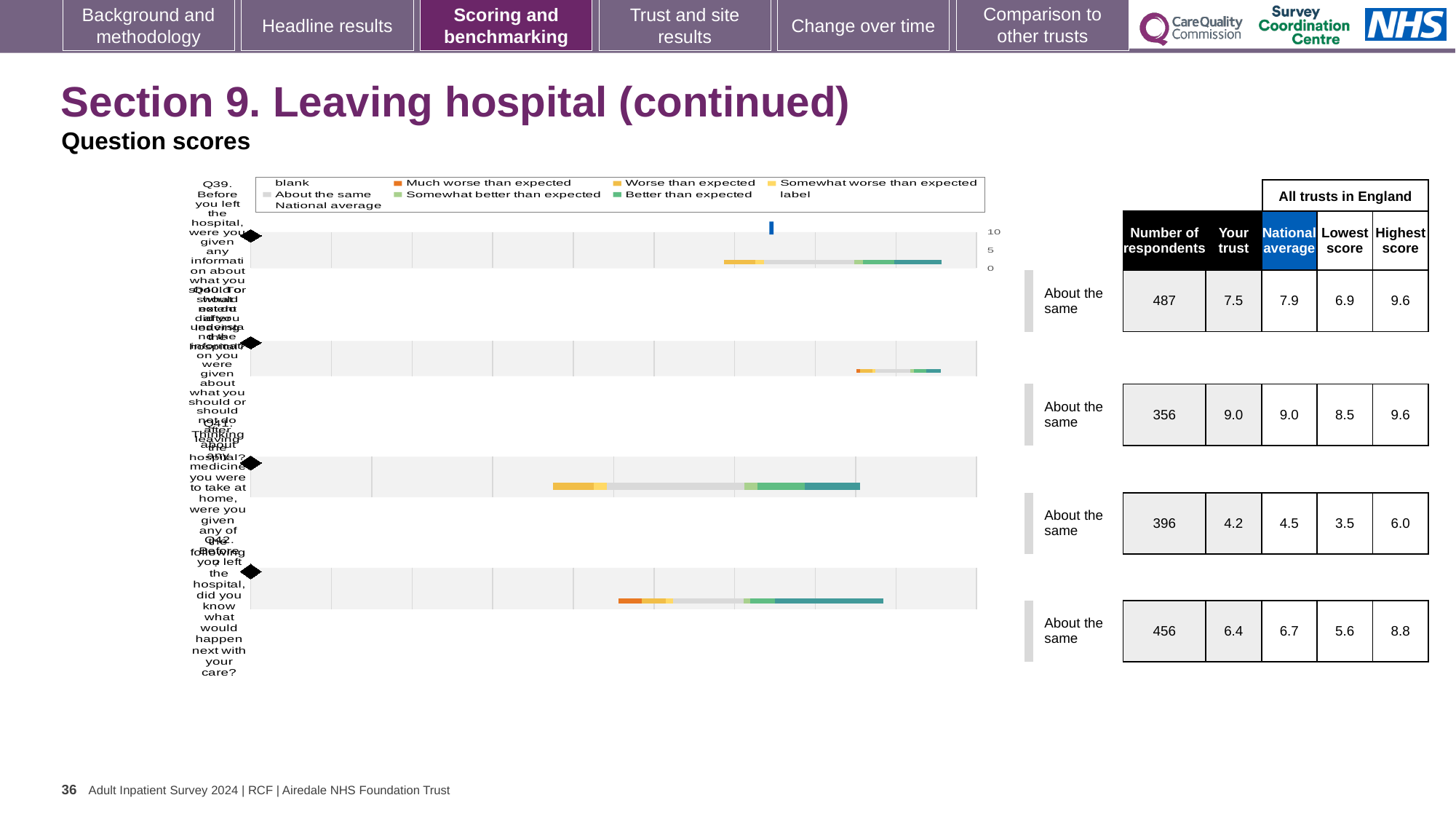
In the table next to the chart, what is the lowest score in the second row (Q40)? 8.5 In the table next to the chart, which row has the lowest 'Your trust' score? third row (4.2) Which legend entry is shown in orange in the chart? Much worse than expected How many question bars are plotted in the chart? 4 In the table next to the chart, which row has the highest number of respondents? first row (487) In the table next to the chart, what is the 'Your trust' score in the first row (Q39)? 7.5 In the table next to the chart, what is the difference between the national average and the 'Your trust' score in the first row? 0.4 In the table next to the chart, is the 'Your trust' score in the fourth row larger or smaller than the national average in that row? smaller In the table next to the chart, what is the number of respondents in the fourth row (Q42)? 456 Which legend entry is shown in dark teal in the chart? Better than expected What kind of chart is shown on the slide? bar chart In the table next to the chart, what is the national average in the third row (Q41)? 4.5